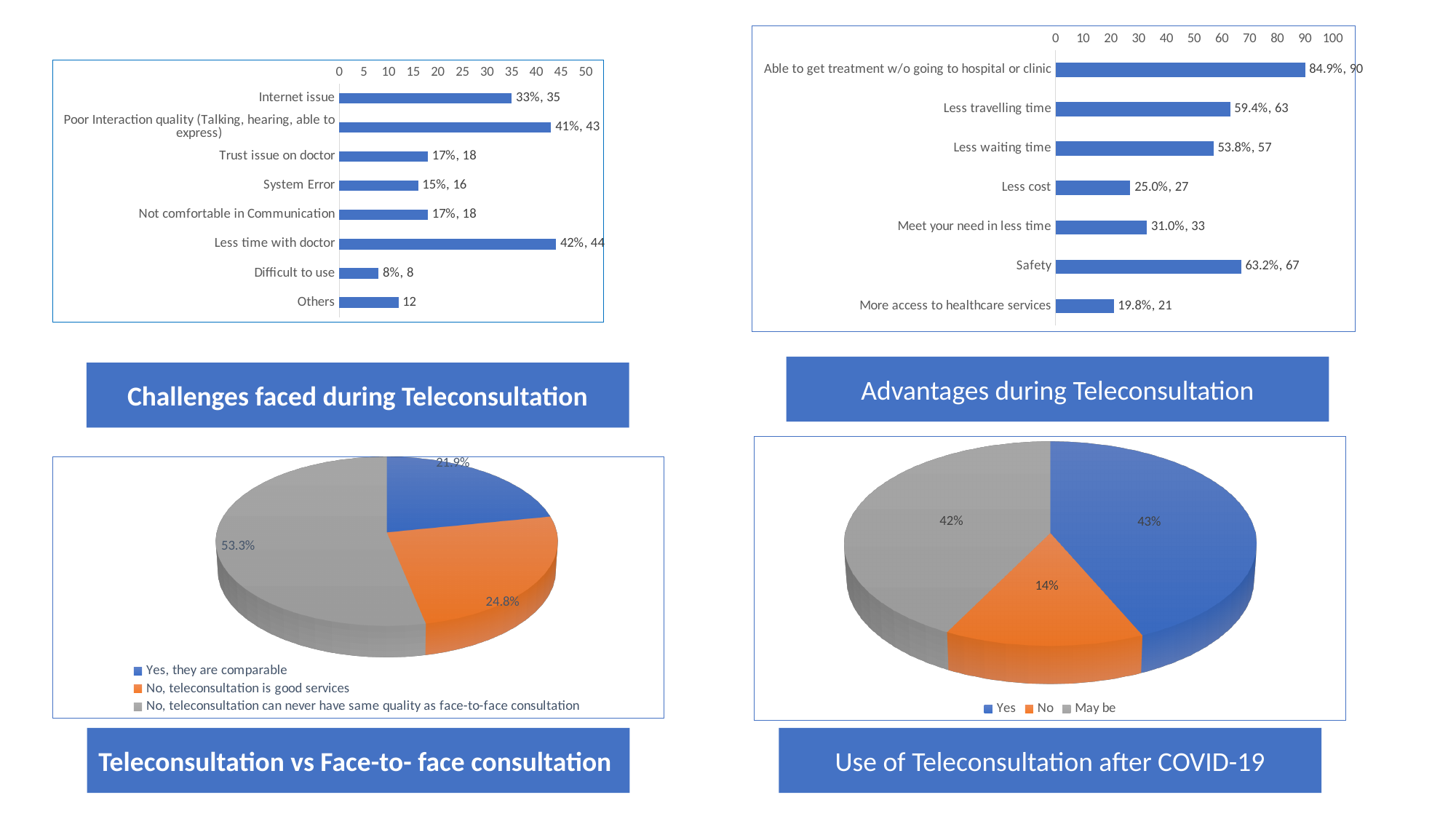
In the 'Advantages during Teleconsultation' chart, which is larger: 'Less cost' or 'Meet your need in less time'? Meet your need in less time In the 'Challenges faced during Teleconsultation' chart, which category has the highest value? Less time with doctor In the 'Advantages during Teleconsultation' chart, what is the data label for 'Safety'? 63.2%, 67 In the 'Teleconsultation vs Face-to- face consultation' pie chart, what share is 'No, teleconsultation can never have same quality as face-to-face consultation'? 53.3% In the 'Advantages during Teleconsultation' chart, which category has the highest value? Able to get treatment w/o going to hospital or clinic What kind of chart is 'Advantages during Teleconsultation'? Bar chart In the 'Challenges faced during Teleconsultation' chart, how many categories are plotted? 8 How many entries does the legend of the 'Use of Teleconsultation after COVID-19' pie chart list? 3 In the 'Advantages during Teleconsultation' chart, what is the difference in count between 'Less travelling time' (63) and 'Less waiting time' (57)? 6 In the 'Challenges faced during Teleconsultation' chart, which category has the lowest value? Difficult to use In the 'Use of Teleconsultation after COVID-19' pie chart, what share is 'No'? 14% In the 'Challenges faced during Teleconsultation' chart, what is the data label for 'Internet issue'? 33%, 35